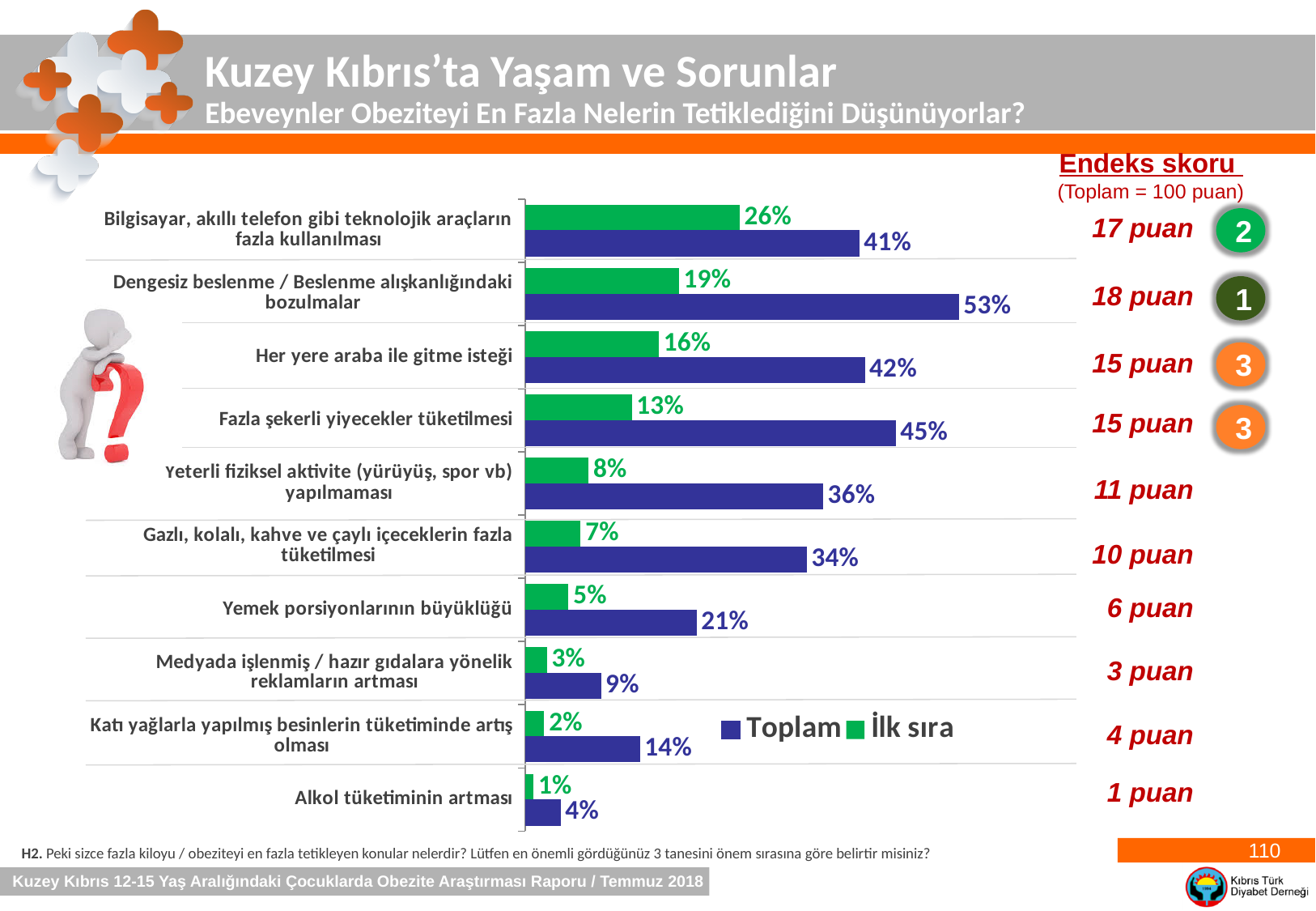
What is the Toplam value for "Dengesiz beslenme / Beslenme alışkanlığındaki bozulmalar"? 53% What kind of chart is shown on the slide? Bar chart What is the İlk sıra value for "Yemek porsiyonlarının büyüklüğü"? 5% What is the difference between the Toplam and İlk sıra values for "Fazla şekerli yiyecekler tüketilmesi"? 32% How many series does the legend list? 2 What is the İlk sıra value for "Bilgisayar, akıllı telefon gibi teknolojik araçların fazla kullanılması"? 26% How many categories are shown in the chart? 10 What is the Toplam value for "Alkol tüketiminin artması"? 4% Which is larger: the Toplam value for "Her yere araba ile gitme isteği" or the Toplam value for "Bilgisayar, akıllı telefon gibi teknolojik araçların fazla kullanılması"? Her yere araba ile gitme isteği Which category has the highest Toplam value? Dengesiz beslenme / Beslenme alışkanlığındaki bozulmalar Which category has the lowest İlk sıra value? Alkol tüketiminin artması Which colour represents the Toplam series in the chart? Blue